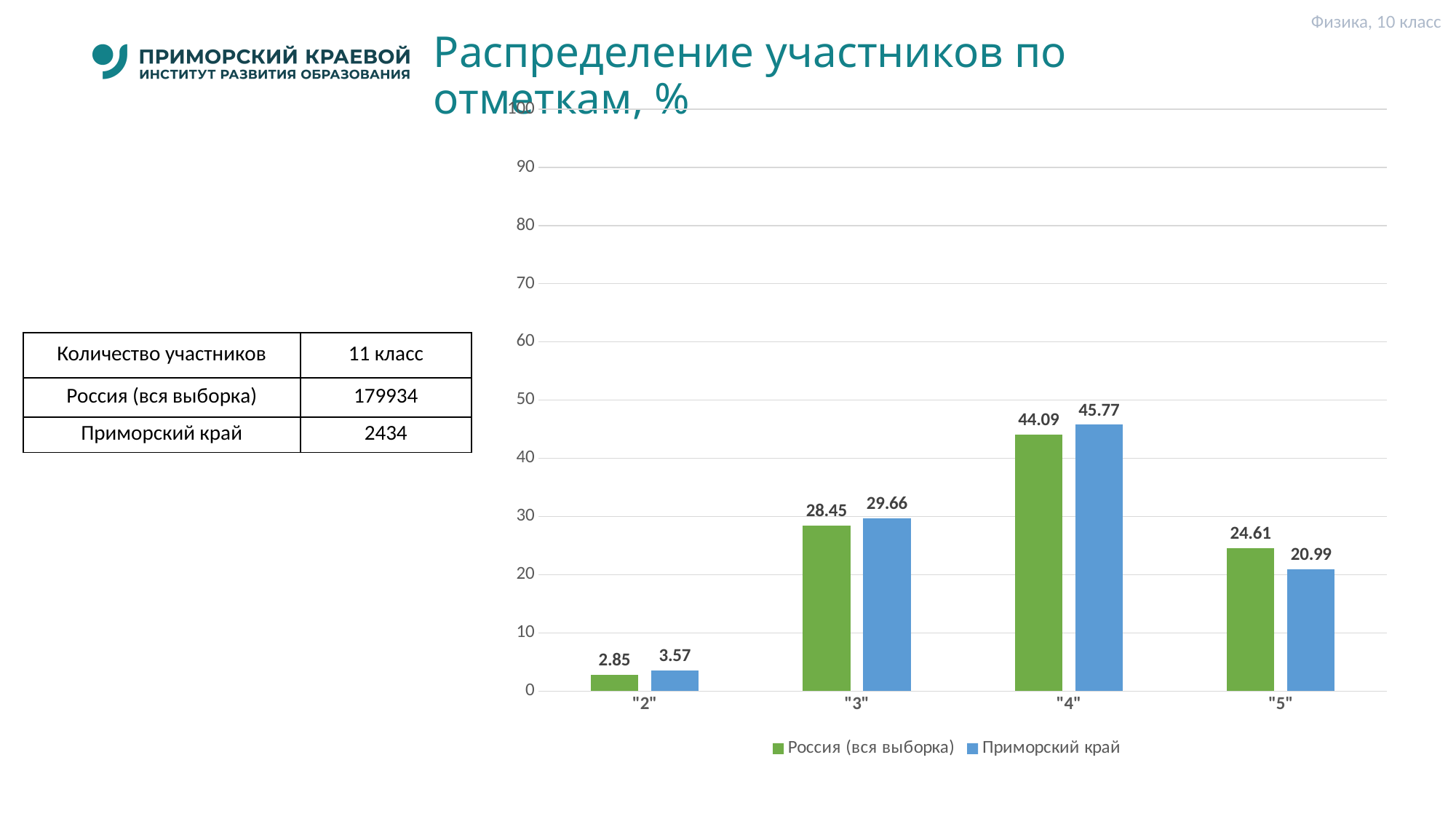
What is the value for Приморский край for mark "2"? 3.57 What is the value for Приморский край for mark "5"? 20.99 How many mark categories are shown on the x axis? 4 For mark "5", which series has the larger value: Россия (вся выборка) or Приморский край? Россия (вся выборка) How many series does the legend list? 2 Which mark has the highest value for Приморский край? "4" What is the value for Россия (вся выборка) for mark "4"? 44.09 Which mark has the lowest value for Россия (вся выборка)? "2" What is the difference between Приморский край and Россия (вся выборка) for mark "3"? 1.21 What kind of chart is shown on the slide? bar chart Which colour represents Приморский край in the chart? blue Is the value for Приморский край for mark "4" greater or less than 40? greater